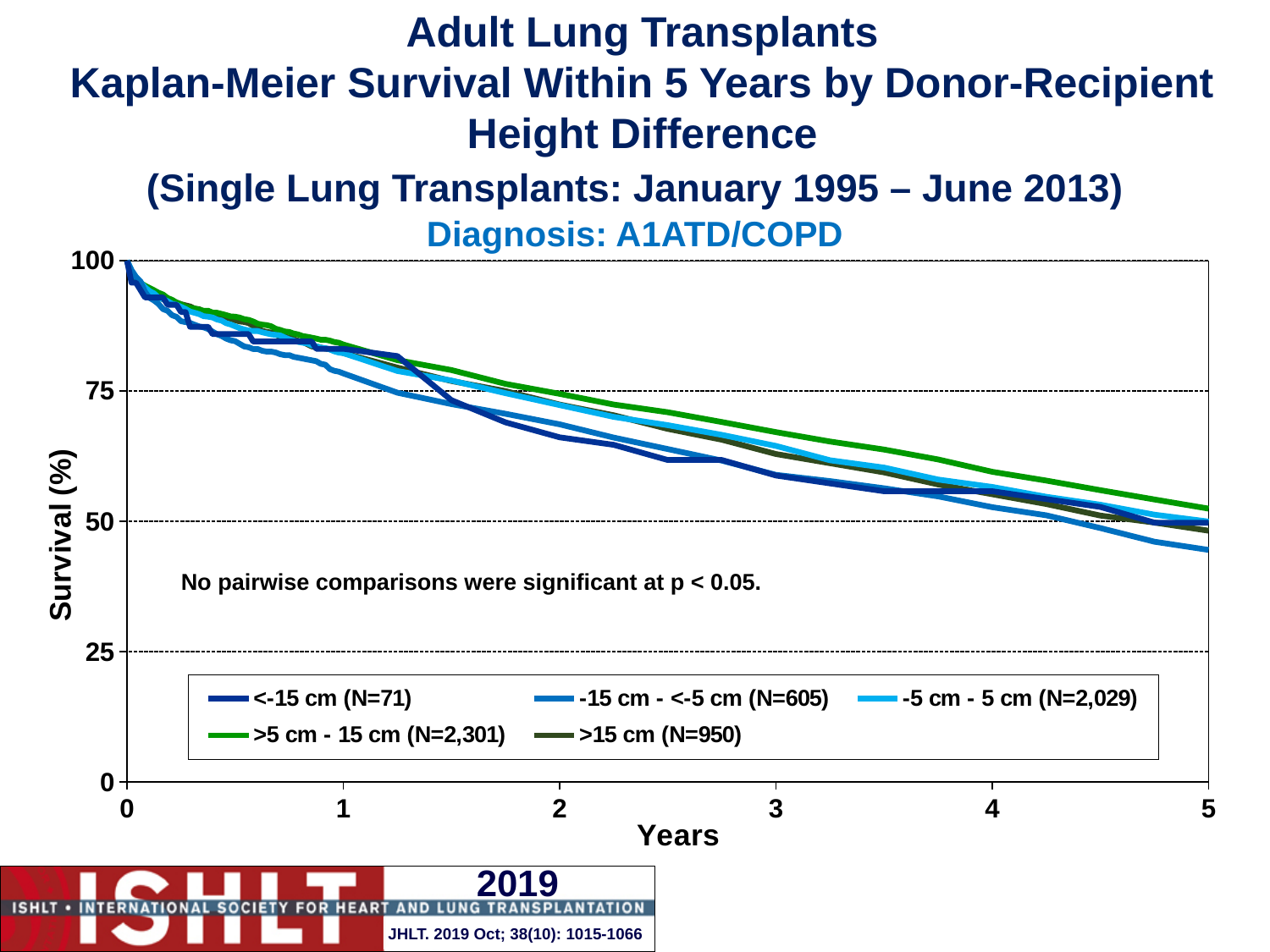
Do the survival curves rise or fall as the years increase? Fall What is the label of the y axis? Survival (%) What kind of chart is shown on the slide? Line chart At 3 years, is the survival for the <-15 cm group greater or less than 75? less At 1 year, is the survival for the -5 cm - 5 cm group greater or less than 75? greater Which group has the highest survival at 5 years? >5 cm - 15 cm At 4 years, is the survival for the >5 cm - 15 cm group greater or less than 50? greater According to the legend, what is the N for the >5 cm - 15 cm group? 2,301 How many series does the legend list? 5 Which group has the lowest survival at 5 years? -15 cm - <-5 cm